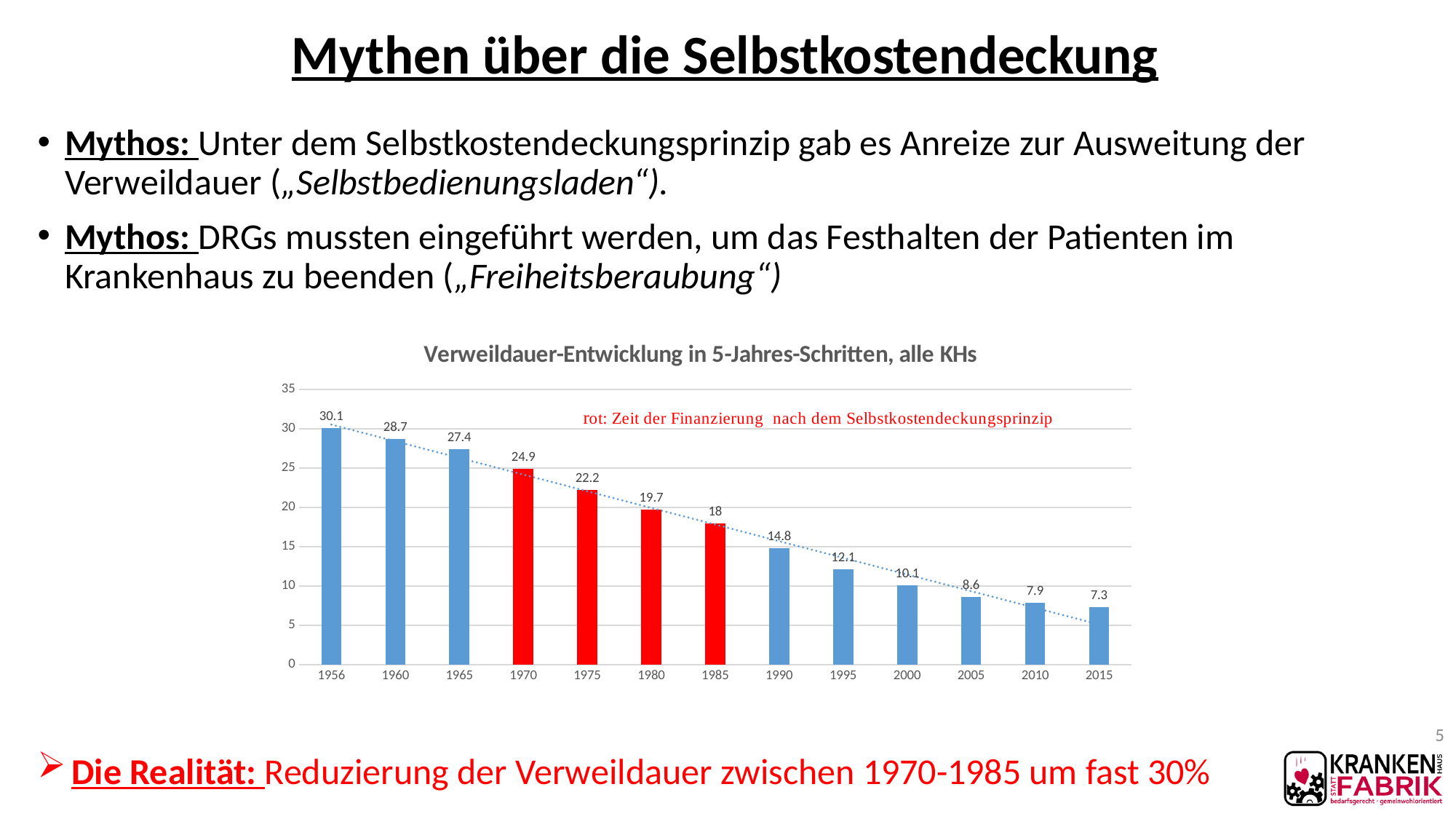
What is the difference between the values for 1970 and 1985? 6.9 Which is larger, the value for 1975 or the value for 1990? 1975 What is the value for 2015? 7.3 Which year has the highest value? 1956 Is the value for 1980 greater or less than 20? less How many years are shown on the x axis? 13 What is the value for 1970? 24.9 What is the value for 1985? 18 Which year has the lowest value? 2015 What is the title of the chart? Verweildauer-Entwicklung in 5-Jahres-Schritten, alle KHs Do the values rise or fall from 1956 to 2015? fall What kind of chart is this? bar chart